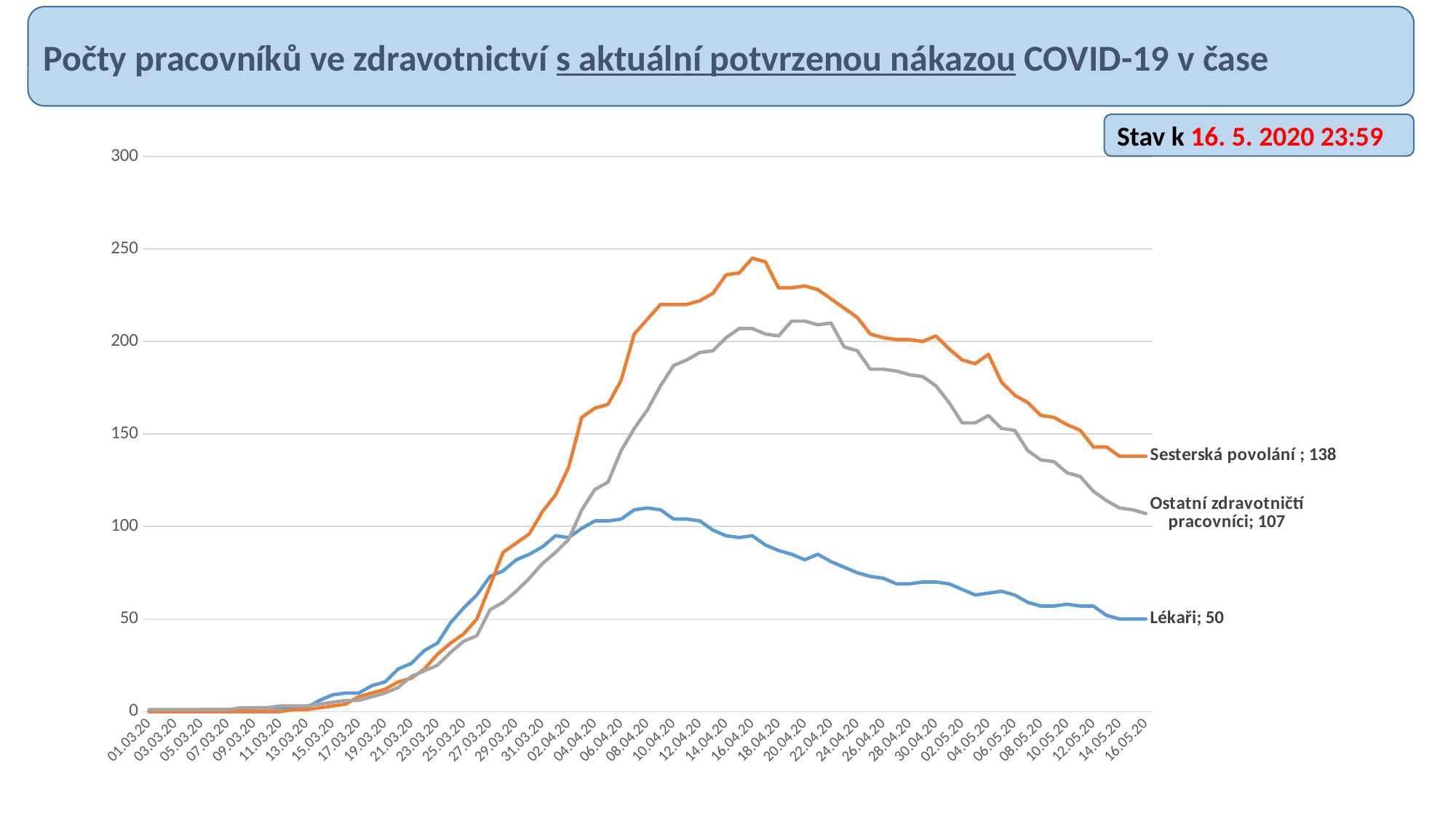
What is the difference between the final labelled values of Sesterská povolání and Ostatní zdravotničtí pracovníci? 31 Which series has the highest labelled final value? Sesterská povolání Which series has the lowest labelled final value? Lékaři What is the value labelled for Lékaři at the end of the series? 50 What is the value labelled for Sesterská povolání at the end of the series? 138 Is the peak value of the Lékaři line greater or less than 150? less What is the value labelled for Ostatní zdravotničtí pracovníci at the end of the series? 107 What kind of chart is shown on the slide? line chart Does the Sesterská povolání line rise or fall between 16.04.20 and 16.05.20? fall What is the difference between the final labelled values of Ostatní zdravotničtí pracovníci and Lékaři? 57 Is the peak value of the Sesterská povolání line greater or less than 200? greater How many series are plotted on the chart? 3